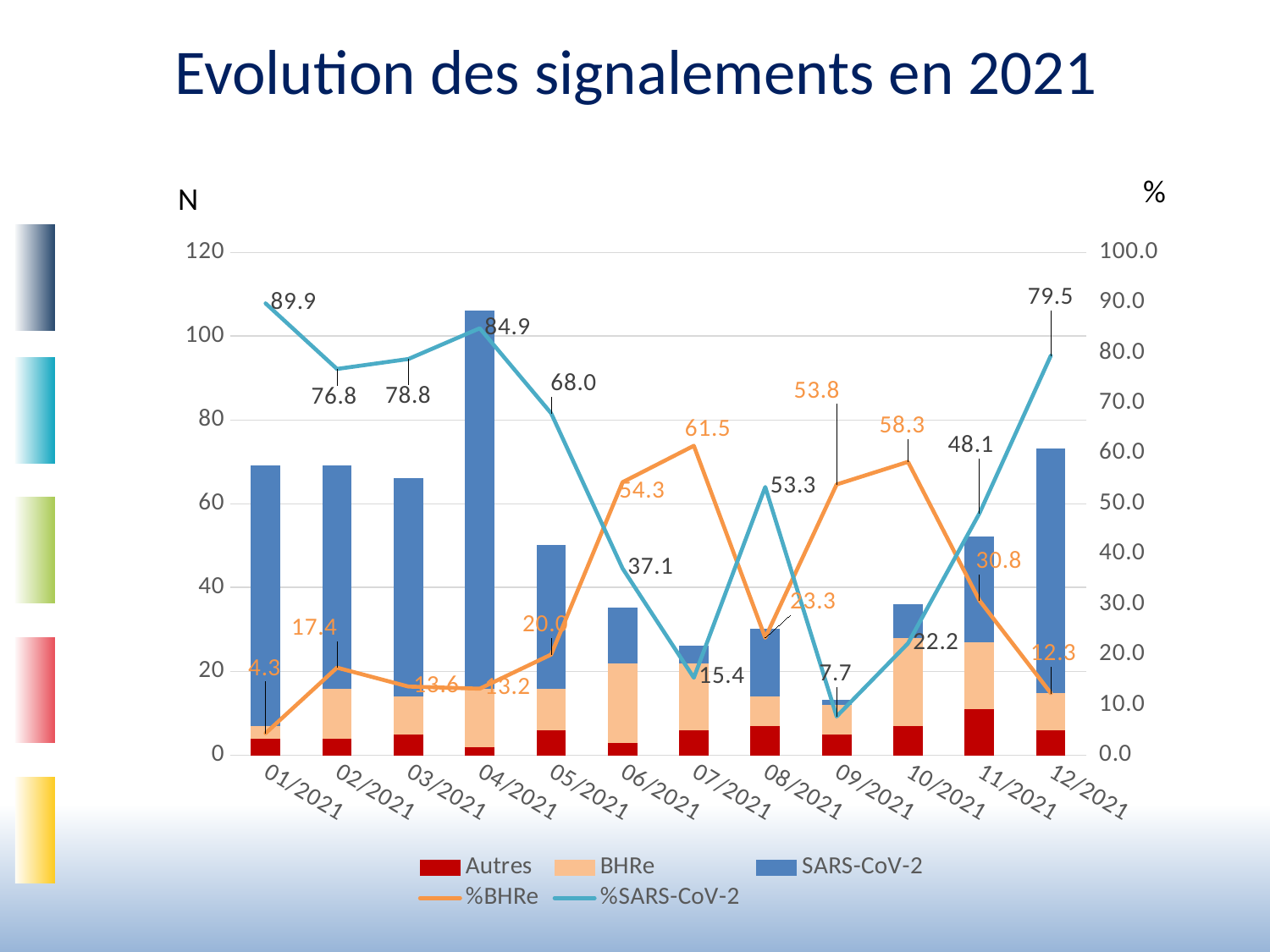
What kind of chart is shown on the slide? Combination stacked bar and line chart In which month is the %SARS-CoV-2 line at its highest? 01/2021 What is the difference between the %SARS-CoV-2 values for 01/2021 and 12/2021? 10.4 In which month is the %SARS-CoV-2 line at its lowest? 09/2021 What is the %SARS-CoV-2 value for 01/2021? 89.9 Which month has the tallest stacked bar? 04/2021 How many series does the legend list? 5 What is the %BHRe value for 07/2021? 61.5 In which month is the %BHRe line at its lowest? 01/2021 Which month has the larger %BHRe value, 06/2021 or 09/2021? 06/2021 How many months are shown on the x axis? 12 Is the total height of the stacked bar for 04/2021 greater or less than 100 on the N axis? greater